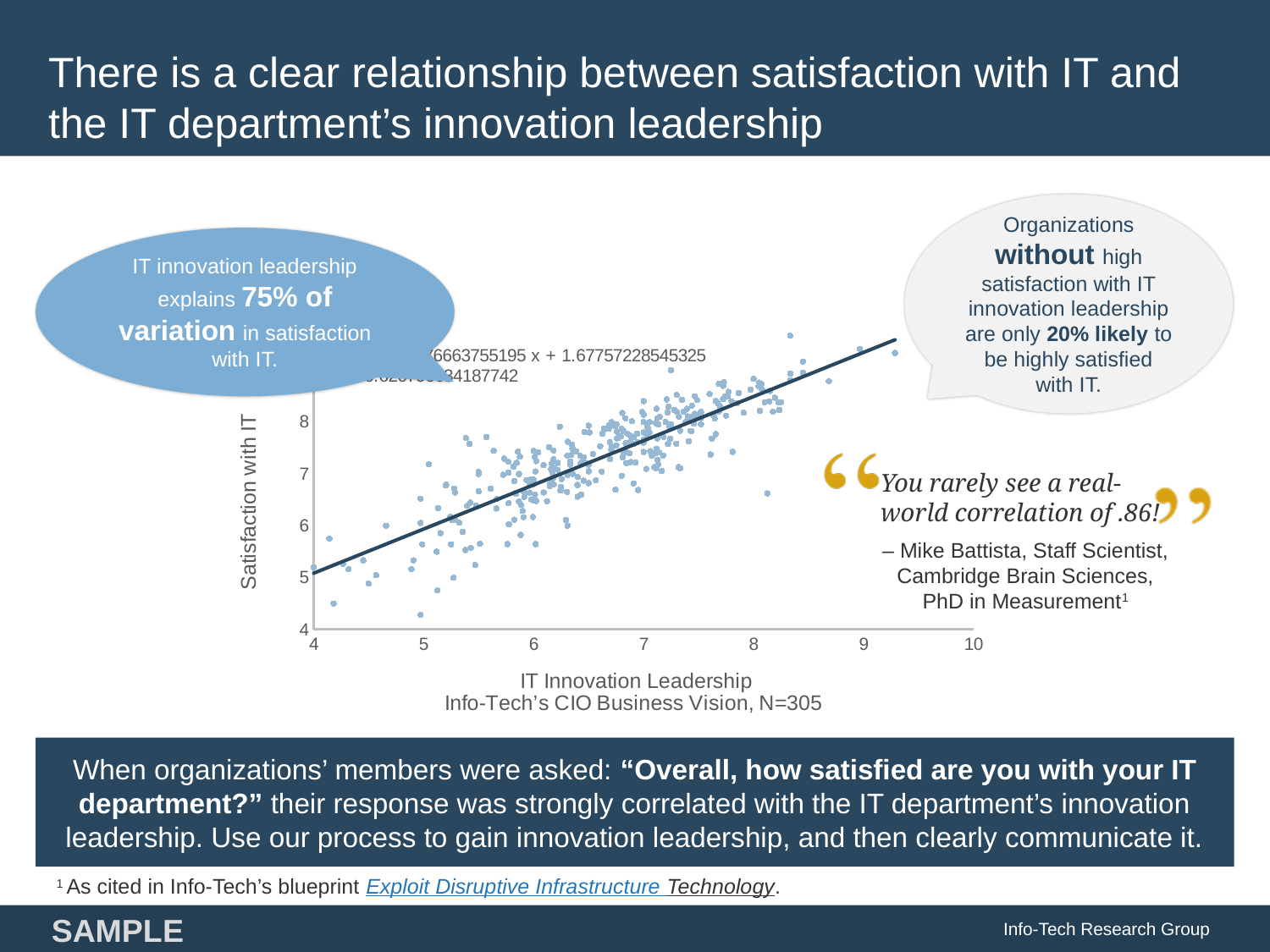
Is the trend line's Satisfaction with IT value at IT Innovation Leadership of 7 greater or less than 6? greater What is the lowest tick value shown on the y axis? 4 What is the label of the y axis of the scatter chart? Satisfaction with IT As IT Innovation Leadership increases along the x axis, does Satisfaction with IT tend to rise or fall? Rise What kind of chart is shown on the slide? Scatter chart Is the trend line's Satisfaction with IT value at IT Innovation Leadership of 9 greater or less than 8? greater What is the highest tick value shown on the x axis? 10 What is the highest tick value shown on the y axis? 8 What is the label of the x axis of the scatter chart? IT Innovation Leadership How many observations (N) does the chart's caption state? 305